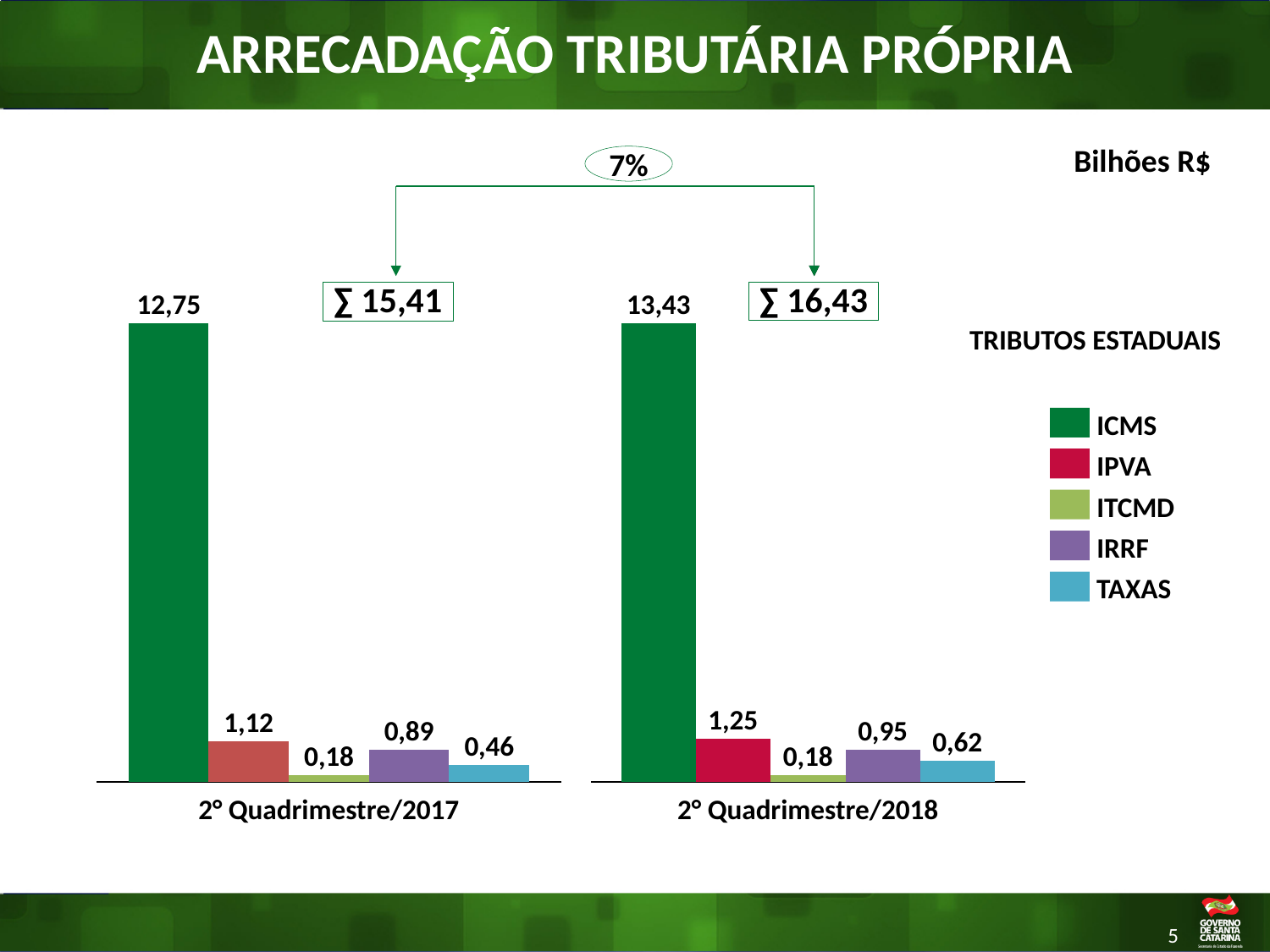
What kind of chart is shown on the slide? Bar chart Which tax has the lowest value in 2º Quadrimestre/2018? ITCMD What is the value for TAXAS in 2º Quadrimestre/2017? 0,46 What is the total (∑) shown for 2º Quadrimestre/2018? 16,43 What is the value for IPVA in 2º Quadrimestre/2018? 1,25 Which tax has the highest value in 2º Quadrimestre/2017? ICMS Which is larger, TAXAS in 2º Quadrimestre/2017 or TAXAS in 2º Quadrimestre/2018? 2º Quadrimestre/2018 What is the value for ICMS in 2º Quadrimestre/2018? 13,43 What percentage change is shown between the two totals? 7% What is the value for ICMS in 2º Quadrimestre/2017? 12,75 What is the difference between the IRRF values for 2º Quadrimestre/2018 and 2º Quadrimestre/2017? 0,06 How many series does the legend list? 5